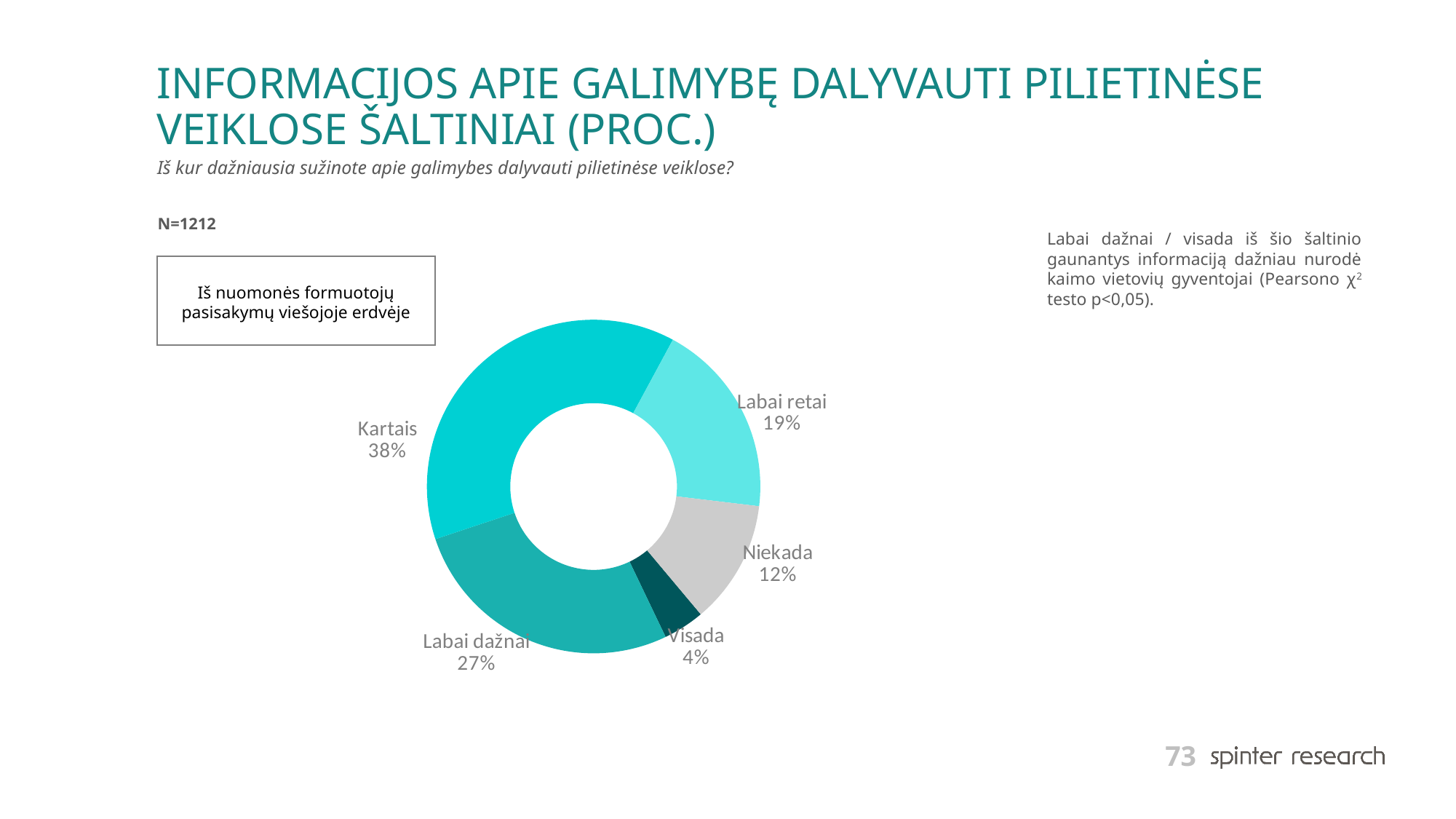
What percentage of respondents answered "Kartais"? 38% What is the combined share of "Labai dažnai" and "Visada"? 31% What percentage of respondents answered "Labai dažnai"? 27% How many categories are shown in the chart? 5 What is the difference in percentage points between "Kartais" and "Labai dažnai"? 11 What percentage of respondents answered "Niekada"? 12% What kind of chart is shown on the slide? Doughnut chart What percentage of respondents answered "Visada"? 4% What is the sample size (N) stated on the slide? N=1212 Which category has the largest share of the chart? Kartais Which is larger, the share for "Labai retai" or the share for "Niekada"? Labai retai Which category has the smallest share of the chart? Visada